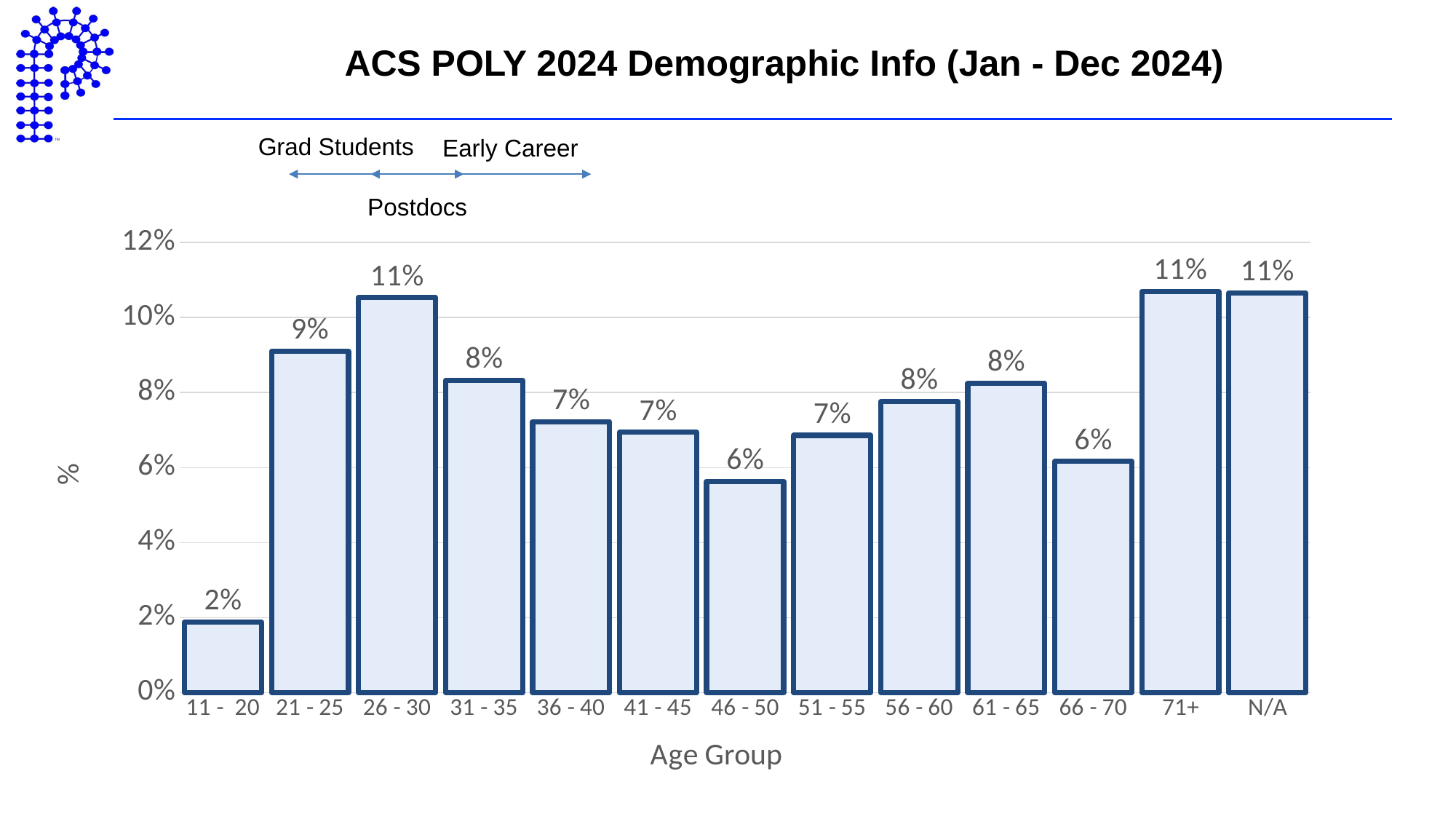
Which age group has the lowest value? 11 - 20 What is the value for the 11 - 20 age group? 2% Which is larger, the value for 21 - 25 or the value for 31 - 35? 21 - 25 What is the value for the 21 - 25 age group? 9% What is the value for the 46 - 50 age group? 6% What is the label of the x axis? Age Group Is the value for 11 - 20 greater or less than 4%? less Is the value for 26 - 30 greater or less than 10%? greater How many age group categories are shown on the x axis? 13 What is the value for the N/A age group? 11% What is the difference between the values for 21 - 25 and 11 - 20? 7% What kind of chart is shown on the slide? bar chart